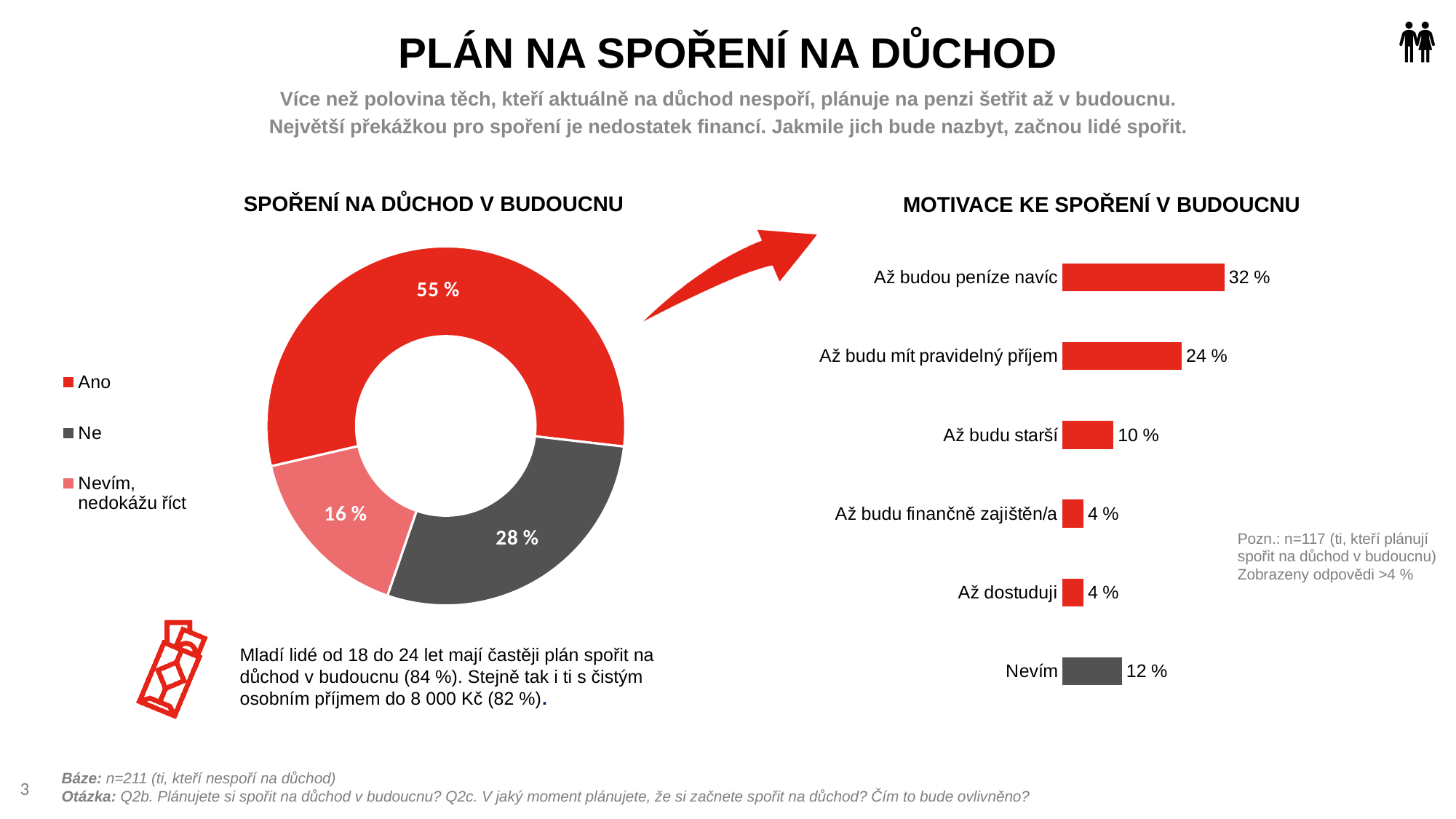
How many categories are shown in the chart 'MOTIVACE KE SPOŘENÍ V BUDOUCNU'? 6 In the chart 'MOTIVACE KE SPOŘENÍ V BUDOUCNU', what is the difference between 'Až budou peníze navíc' and 'Až budu mít pravidelný příjem'? 8 % In the chart 'MOTIVACE KE SPOŘENÍ V BUDOUCNU', which category has the highest value? Až budou peníze navíc In the chart 'SPOŘENÍ NA DŮCHOD V BUDOUCNU', what share of respondents answered 'Ano'? 55 % How many entries does the legend of the chart 'SPOŘENÍ NA DŮCHOD V BUDOUCNU' list? 3 What kind of chart is 'MOTIVACE KE SPOŘENÍ V BUDOUCNU'? Bar chart In the chart 'MOTIVACE KE SPOŘENÍ V BUDOUCNU', what is the value for 'Nevím'? 12 % In the chart 'SPOŘENÍ NA DŮCHOD V BUDOUCNU', what is the value for 'Ne'? 28 % In the chart 'MOTIVACE KE SPOŘENÍ V BUDOUCNU', which is larger: 'Až budu starší' or 'Nevím'? Nevím In the chart 'MOTIVACE KE SPOŘENÍ V BUDOUCNU', what is the value for 'Až budou peníze navíc'? 32 % What kind of chart is 'SPOŘENÍ NA DŮCHOD V BUDOUCNU'? Donut (pie) chart In the chart 'SPOŘENÍ NA DŮCHOD V BUDOUCNU', what is the value for 'Nevím, nedokážu říct'? 16 %